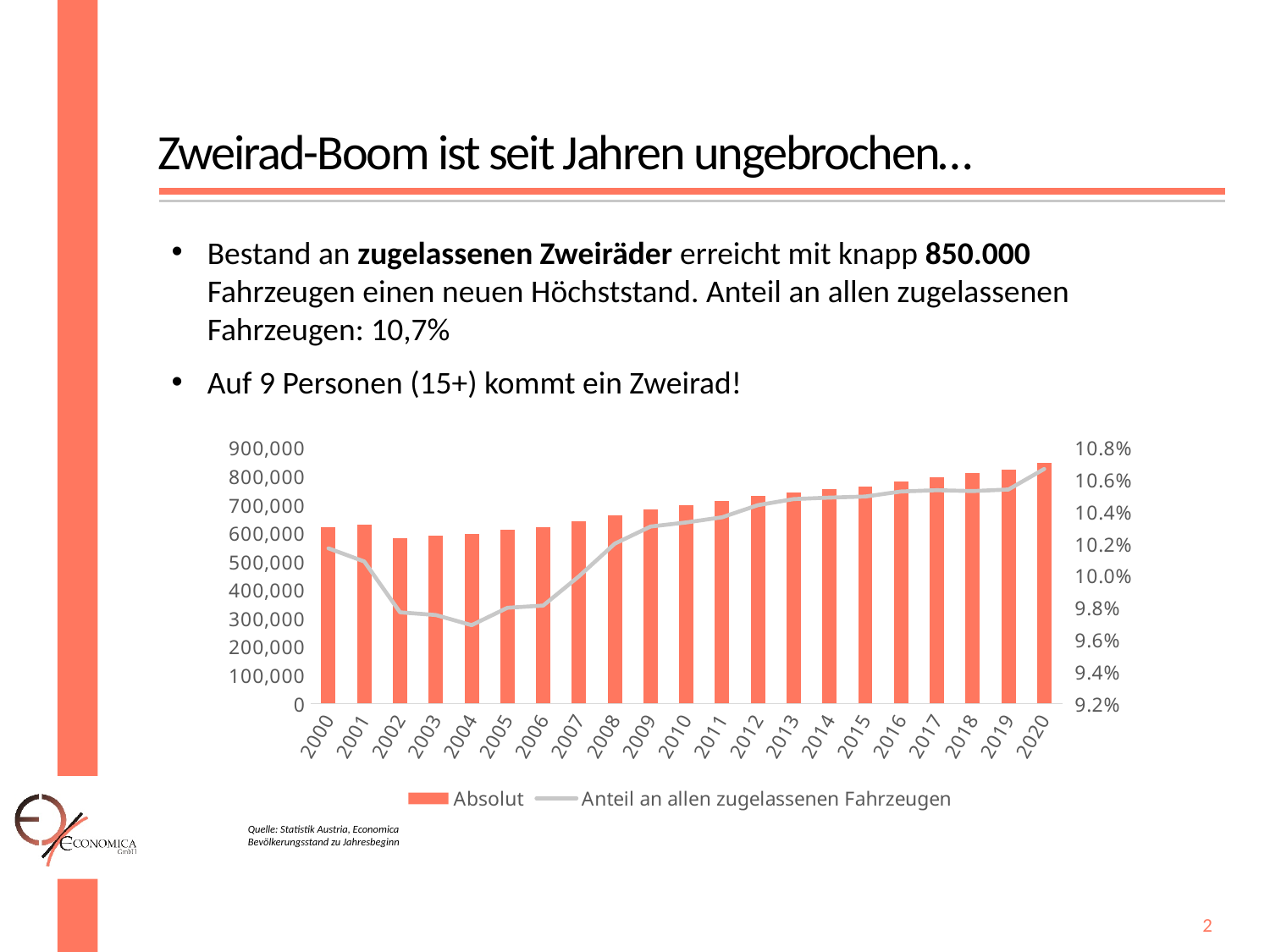
Which year has the highest bar for Absolut? 2020 What kind of chart is shown on the slide? A bar chart combined with a line chart Is the Anteil an allen zugelassenen Fahrzeugen value for 2004 greater or less than 9.8%? less How many years are shown on the x axis of the chart? 21 In which year is the line for Anteil an allen zugelassenen Fahrzeugen at its lowest? 2004 Do the Absolut bars rise or fall from 2004 to 2020? rise Is the Absolut value for 2000 greater or less than 700,000? less Is the Absolut value for 2020 greater or less than 800,000? greater What are the two entries in the chart legend? Absolut; Anteil an allen zugelassenen Fahrzeugen How many series does the chart legend list? 2 Which year has the larger Absolut bar, 2004 or 2008? 2008